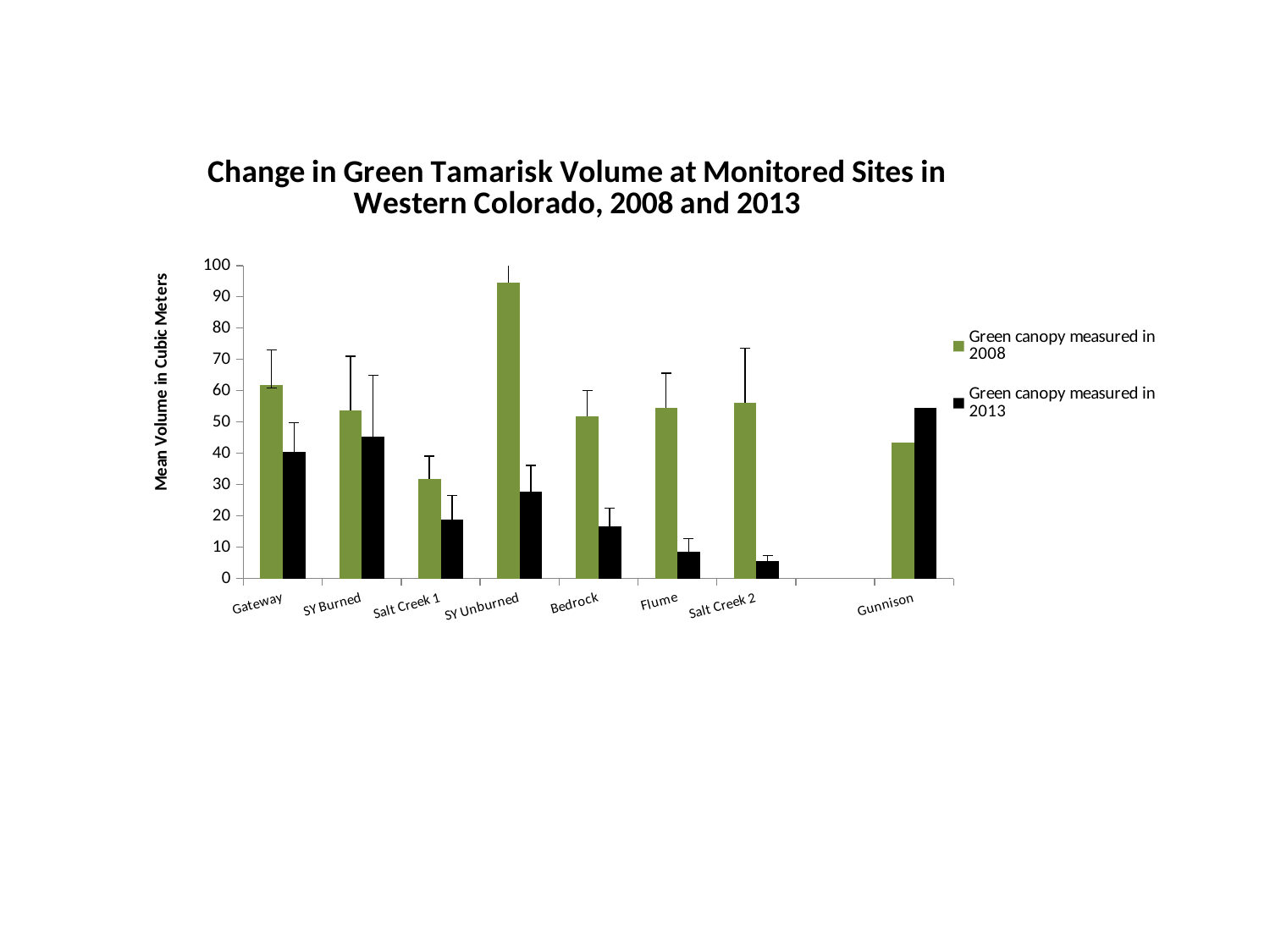
At Gunnison, which is larger: the green canopy measured in 2008 or in 2013? 2013 What kind of chart is shown on the slide? Bar chart What is the label of the y axis? Mean Volume in Cubic Meters Is the 2013 green canopy value for Flume greater or less than 10? less Is the 2008 green canopy value for SY Unburned greater or less than 90? greater Which site has the highest green canopy volume measured in 2013? Gunnison How many sites are labeled on the x axis? 8 Which site has the lowest green canopy volume measured in 2008? Salt Creek 1 Is the 2008 green canopy value for Salt Creek 1 greater or less than 40? less How many series does the legend list? 2 Which site has the highest green canopy volume measured in 2008? SY Unburned At Gateway, which is larger: the green canopy measured in 2008 or in 2013? 2008